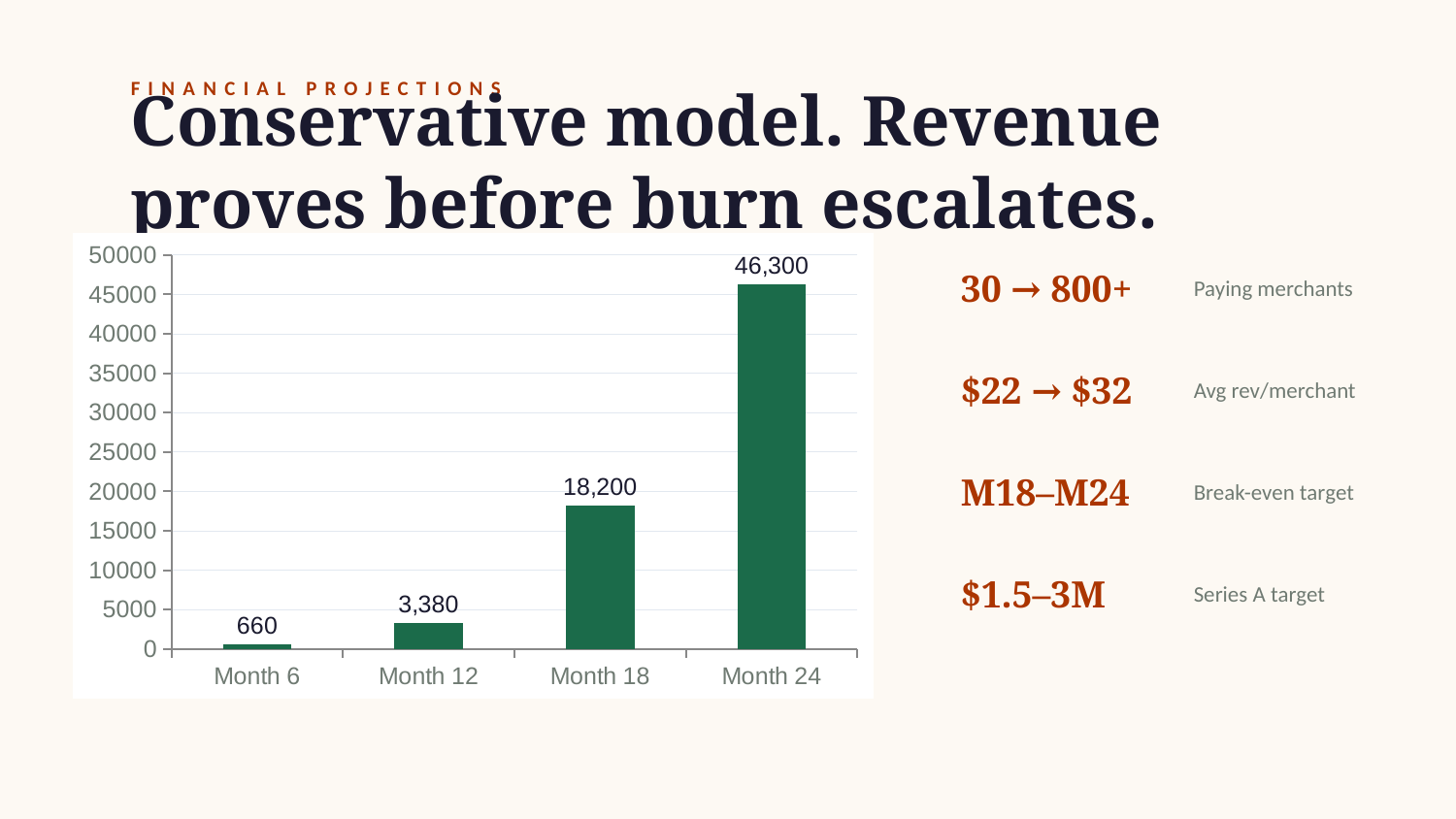
What is the value for Month 12? 3,380 What is the value for Month 24? 46,300 Which month has the lowest value? Month 6 How many categories are shown on the x axis? 4 Is the value for Month 24 greater or less than 45000? greater Which month has the highest value? Month 24 What is the value for Month 18? 18,200 What is the difference between the values for Month 24 and Month 18? 28,100 Which is larger, the value for Month 18 or the value for Month 12? Month 18 What is the difference between the values for Month 12 and Month 6? 2,720 What kind of chart is shown on the slide? bar chart What is the value for Month 6? 660